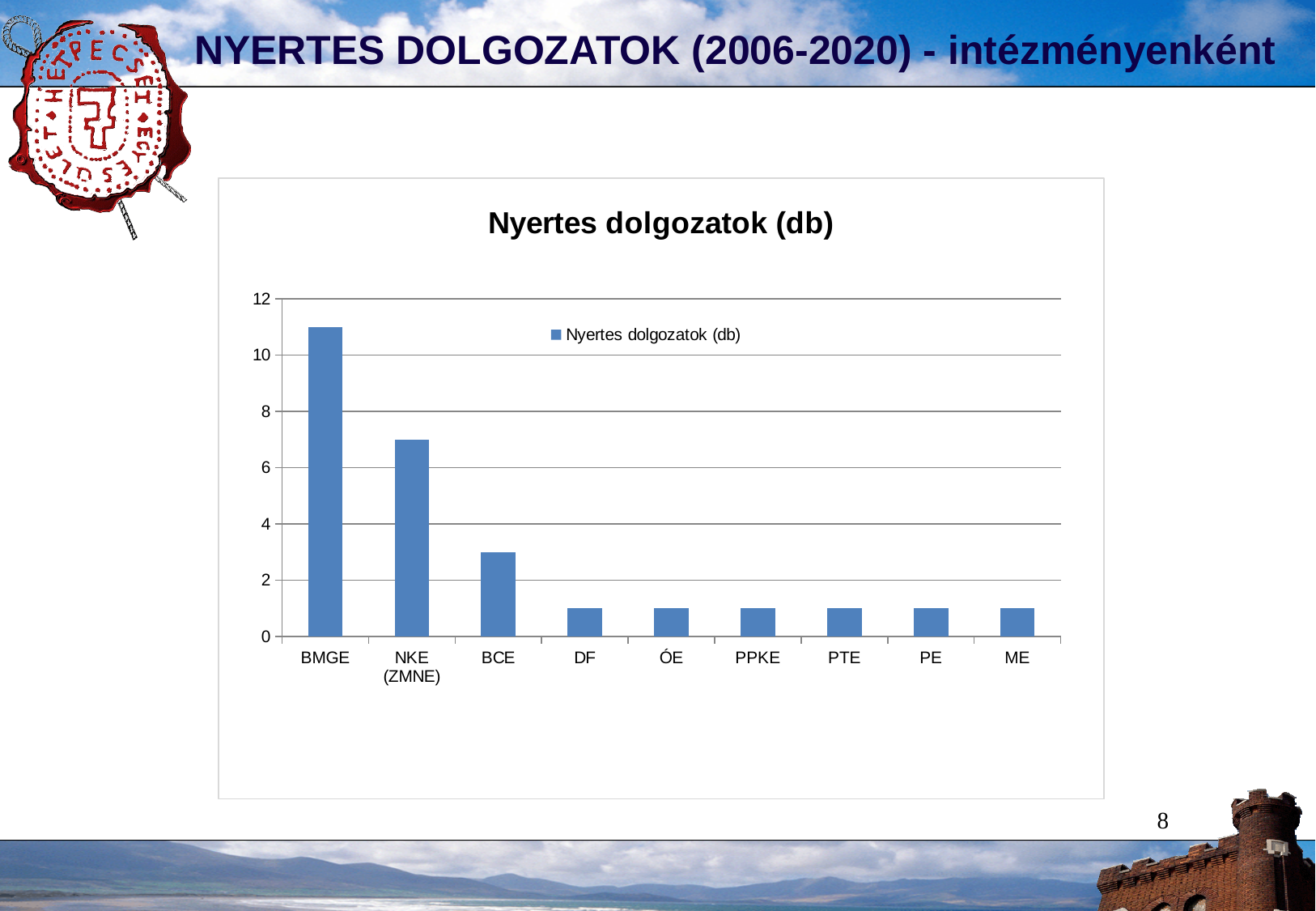
Is the value for NKE (ZMNE) greater or less than 6? greater What kind of chart is shown on the slide? bar chart Which is larger, the value for BCE or the value for PPKE? BCE How many institutions (categories) are shown on the x axis? 9 Is the value for BCE greater or less than 4? less Do the values rise or fall moving from left to right along the x axis? fall Which institution has the highest number of Nyertes dolgozatok? BMGE What is the title of the chart? Nyertes dolgozatok (db) Which is larger, the value for BMGE or the value for NKE (ZMNE)? BMGE Is the value for DF greater or less than 2? less How many series does the legend list? 1